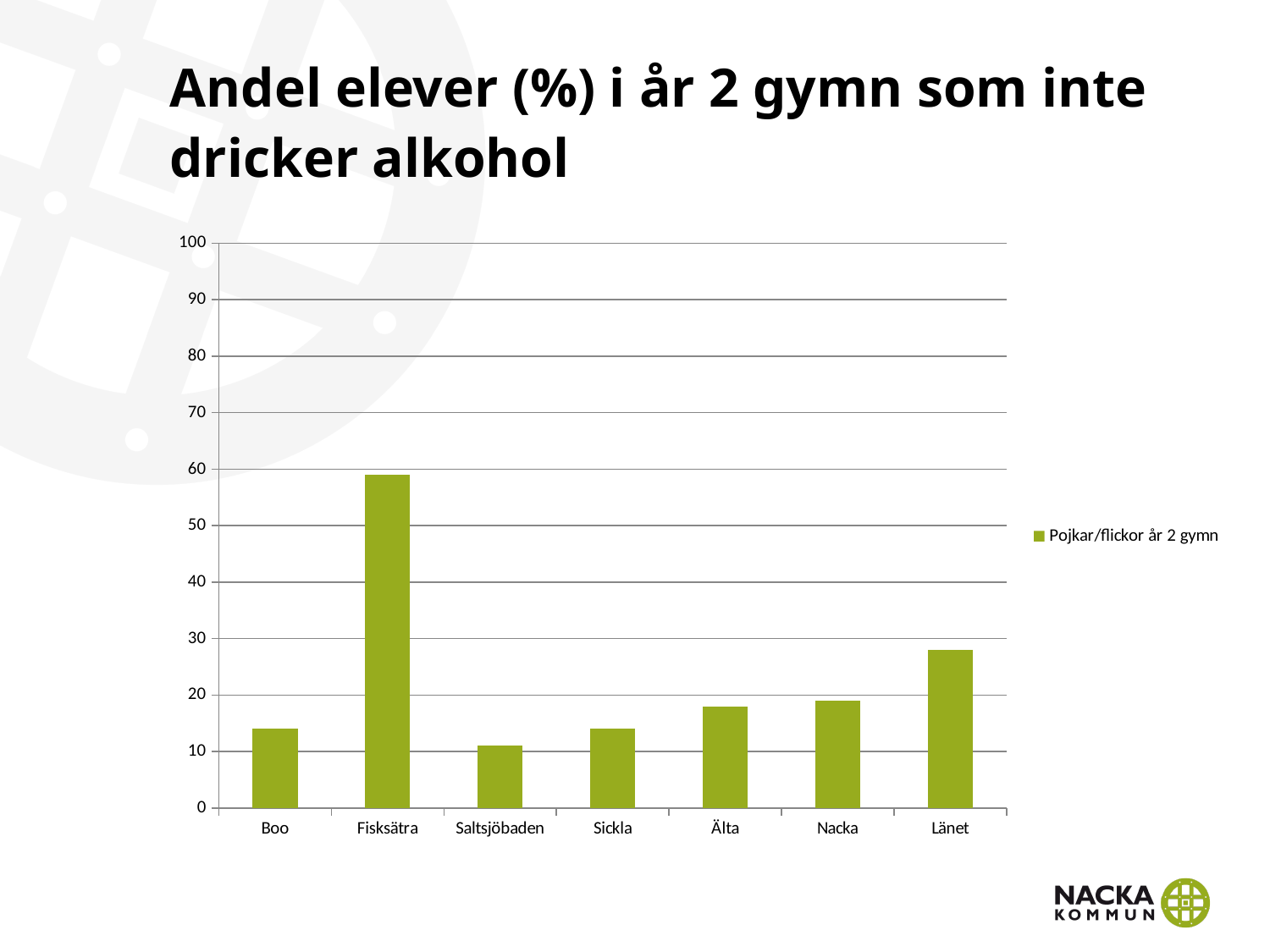
What kind of chart is shown on the slide? bar chart Is the value for Länet greater or less than 30? less Is the value for Fisksätra greater or less than 50? greater Is the value for Länet greater or less than 20? greater Which is larger, the value for Fisksätra or the value for Länet? Fisksätra Which category has the lowest value? Saltsjöbaden Which category has the highest value? Fisksätra How many categories are shown on the x axis of the chart? 7 Which is larger, the value for Länet or the value for Nacka? Länet What is the legend entry for the series in the chart? Pojkar/flickor år 2 gymn How many series does the legend list? 1